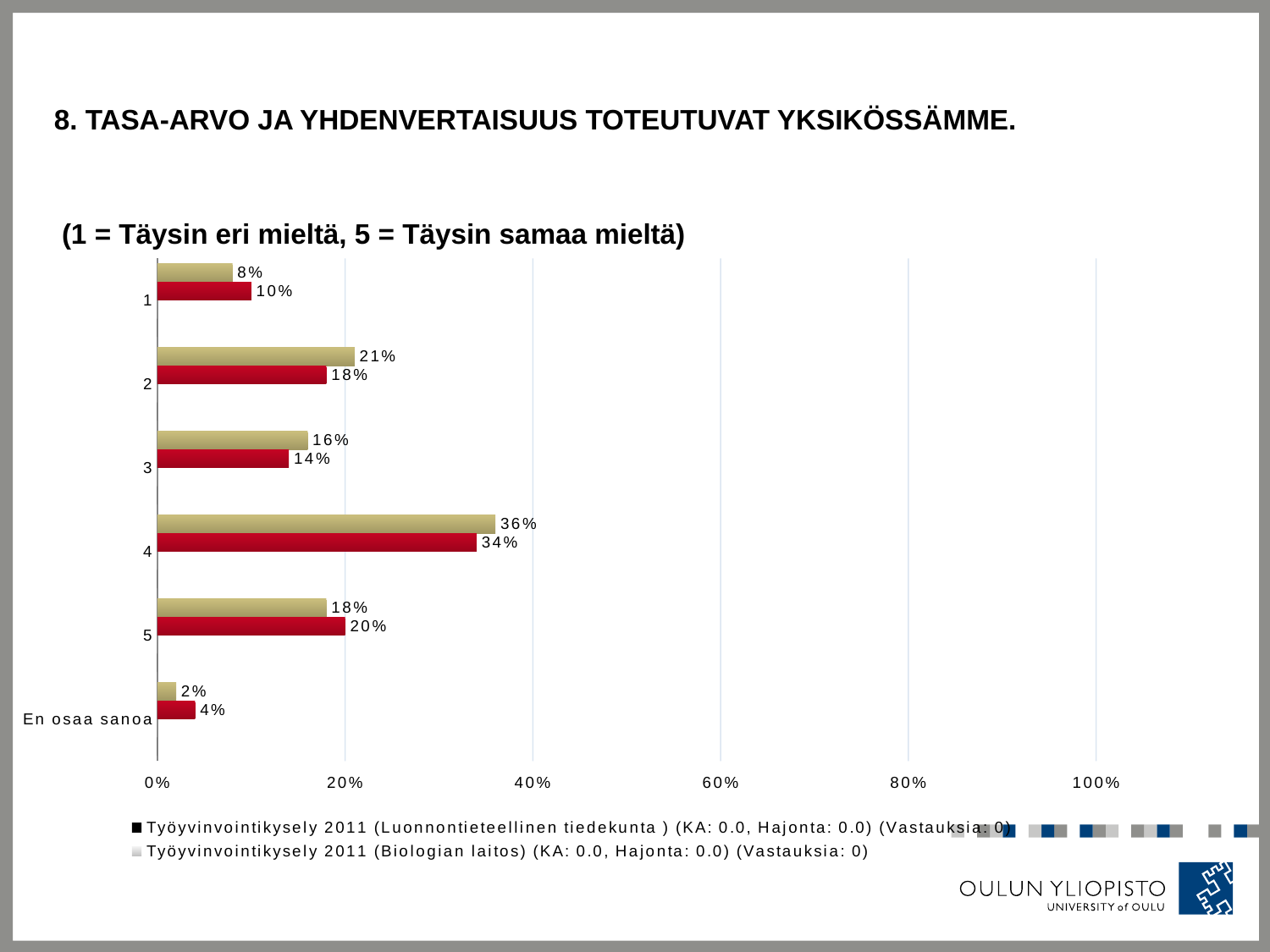
What is the value of the red bar for category 4? 34% What kind of chart is shown on the slide? bar chart What is the difference between the tan bar and the red bar for category 5? 2% Is the value of the tan bar for category 4 greater or less than 20%? greater What is the value of the tan (upper) bar for category 2? 21% Which category has the highest value for the tan (upper) bars? 4 Which category has the lowest value for the red bars? En osaa sanoa How many categories are shown on the vertical axis of the chart? 6 How many series does the chart legend list? 2 What is the difference between the tan bar for category 3 and the tan bar for category 1? 8% For category 1, which bar is larger, the tan bar or the red bar? the red bar What is the value of the red bar for 'En osaa sanoa'? 4%